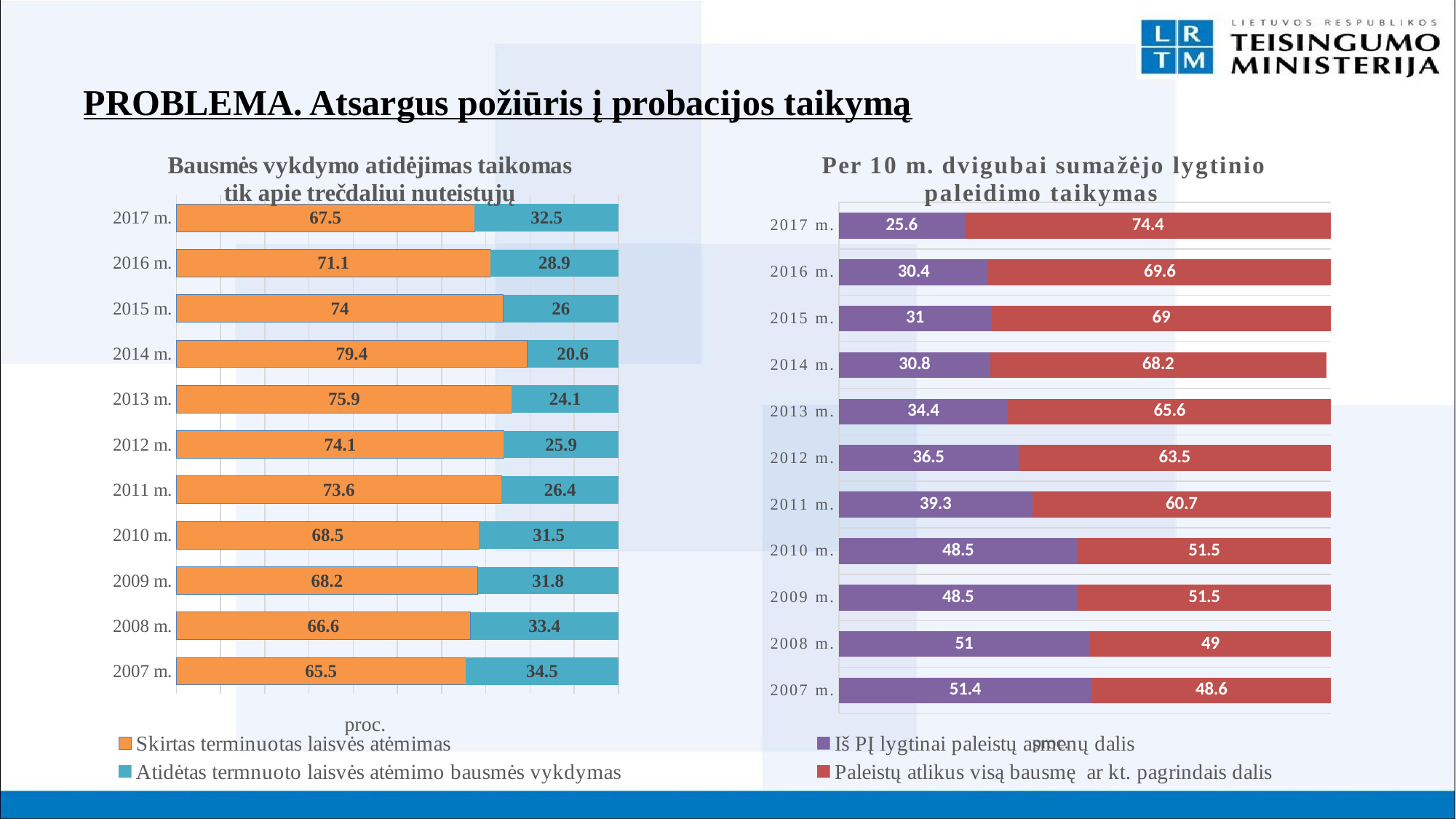
In the left chart (Bausmės vykdymo atidėjimas taikomas tik apie trečdaliui nuteistųjų), which year has the lowest value for Atidėtas termnuoto laisvės atėmimo bausmės vykdymas? 2014 m. In the right chart (Per 10 m. dvigubai sumažėjo lygtinio paleidimo taikymas), which year has the highest value for Iš PĮ lygtinai paleistų asmenų dalis? 2007 m. What type of chart is the right chart (Per 10 m. dvigubai sumažėjo lygtinio paleidimo taikymas)? Stacked bar chart In the right chart (Per 10 m. dvigubai sumažėjo lygtinio paleidimo taikymas), what is the value of Paleistų atlikus visą bausmę ar kt. pagrindais dalis for 2012 m.? 63.5 In the right chart (Per 10 m. dvigubai sumažėjo lygtinio paleidimo taikymas), is the Iš PĮ lygtinai paleistų asmenų dalis value larger for 2011 m. or 2013 m.? 2011 m. In the left chart (Bausmės vykdymo atidėjimas taikomas tik apie trečdaliui nuteistųjų), what is the difference between the Skirtas terminuotas laisvės atėmimas values for 2014 m. and 2007 m.? 13.9 In the left chart (Bausmės vykdymo atidėjimas taikomas tik apie trečdaliui nuteistųjų), how many years are shown? 11 In the right chart (Per 10 m. dvigubai sumažėjo lygtinio paleidimo taikymas), what is the difference between the Iš PĮ lygtinai paleistų asmenų dalis values for 2007 m. and 2017 m.? 25.8 In the left chart (Bausmės vykdymo atidėjimas taikomas tik apie trečdaliui nuteistųjų), what is the value of Atidėtas termnuoto laisvės atėmimo bausmės vykdymas for 2014 m.? 20.6 In the right chart (Per 10 m. dvigubai sumažėjo lygtinio paleidimo taikymas), what is the value of Iš PĮ lygtinai paleistų asmenų dalis for 2017 m.? 25.6 In the left chart (Bausmės vykdymo atidėjimas taikomas tik apie trečdaliui nuteistųjų), which year has the highest value for Skirtas terminuotas laisvės atėmimas? 2014 m. In the left chart (Bausmės vykdymo atidėjimas taikomas tik apie trečdaliui nuteistųjų), what is the value of Skirtas terminuotas laisvės atėmimas for 2017 m.? 67.5